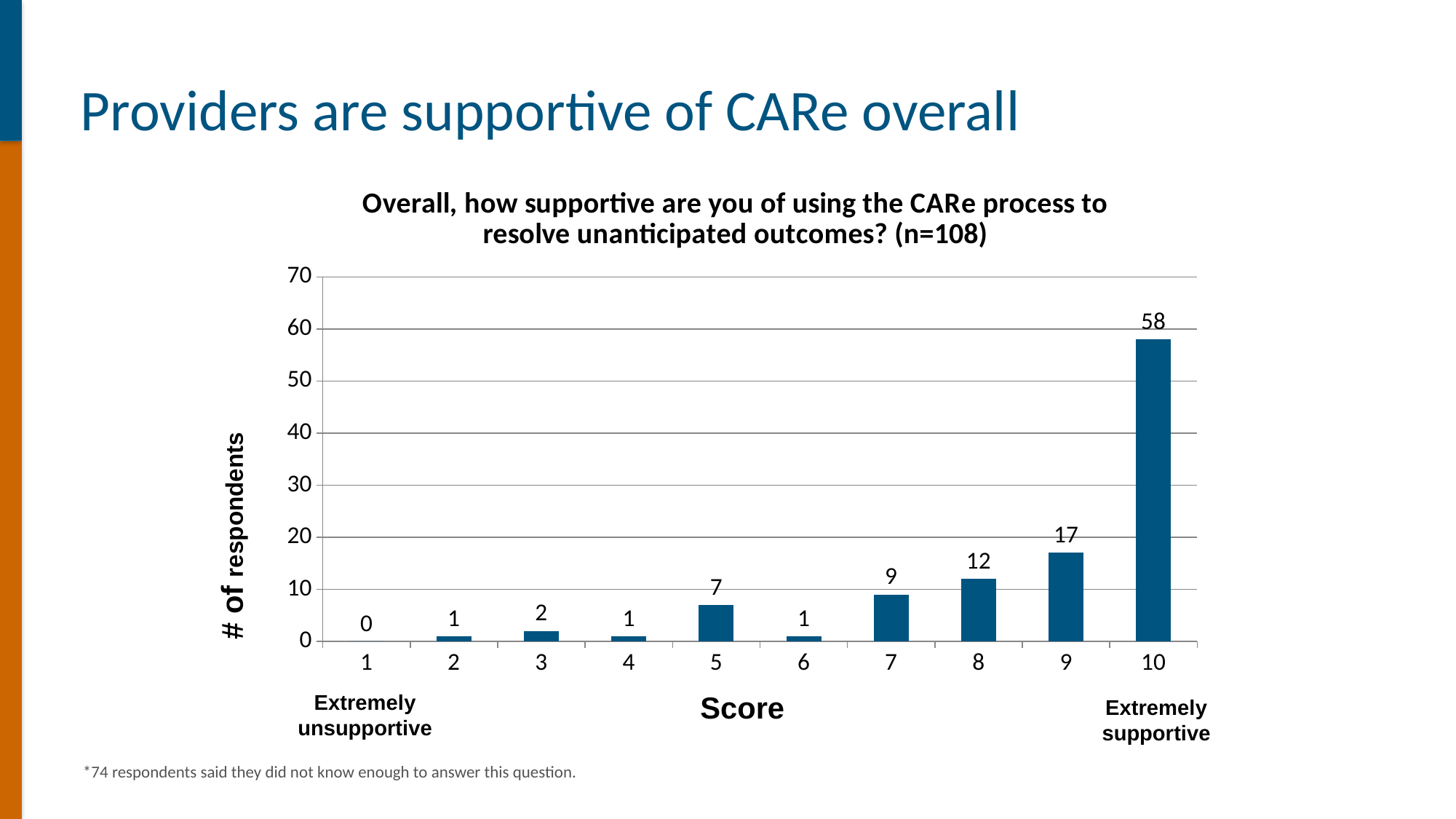
How many score categories are shown on the x axis? 10 What label appears under score 10 on the x axis? Extremely supportive Which score received the most respondents? 10 Which score received the fewest respondents? 1 Which score has more respondents, 7 or 8? 8 Is the number of respondents for score 10 greater or less than 50? greater What is the difference in the number of respondents between score 10 and score 9? 41 What kind of chart is shown on the slide? bar chart How many respondents gave a score of 10? 58 How many respondents gave a score of 5? 7 What is the label of the y axis? # of respondents How many respondents gave a score of 8? 12